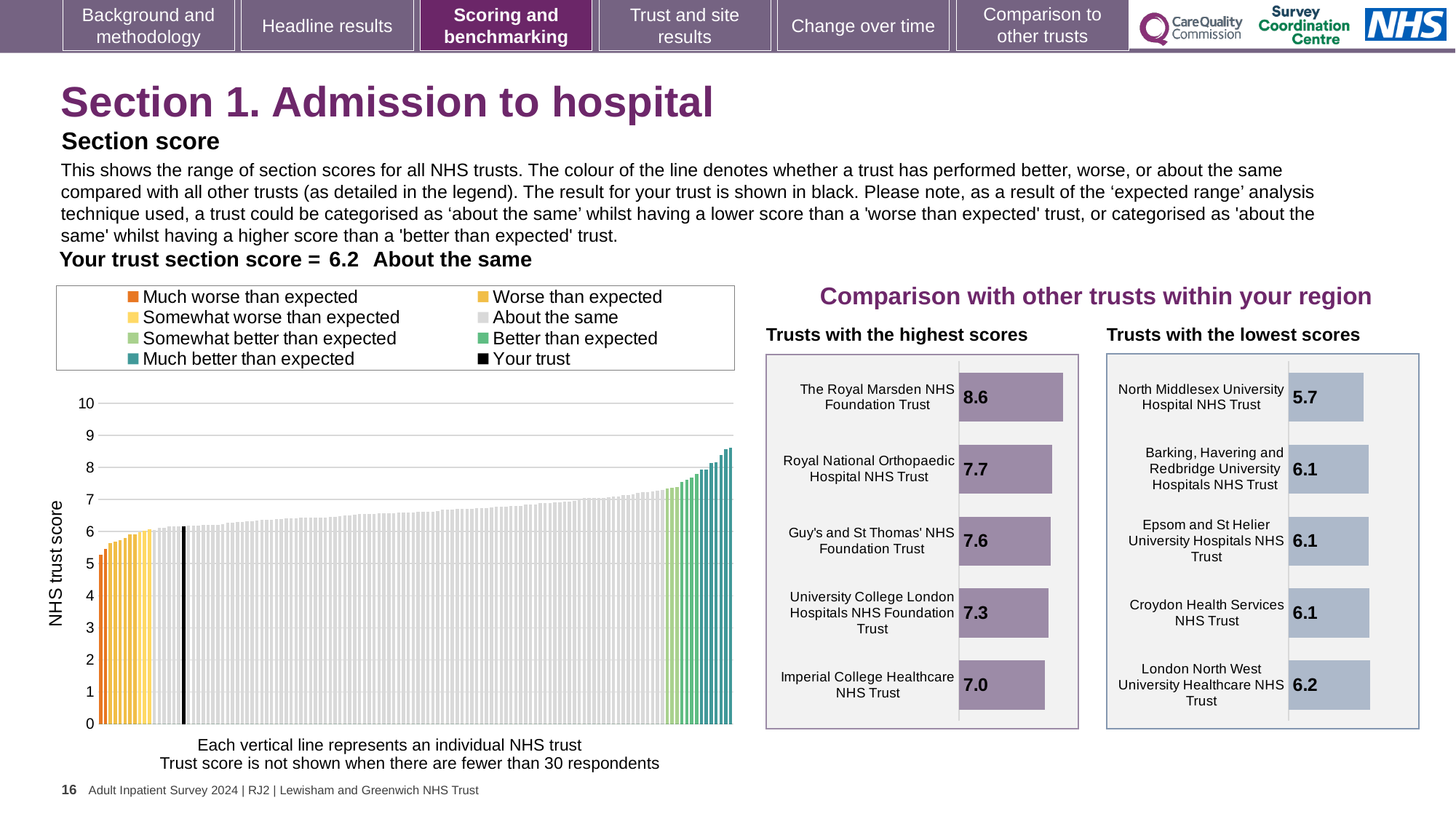
What kind of chart is the large 'NHS trust score' chart on the left? Bar chart How many entries does the legend of the 'NHS trust score' chart on the left list? 8 In the 'Trusts with the highest scores' chart, what is the difference between the scores of The Royal Marsden NHS Foundation Trust and Imperial College Healthcare NHS Trust? 1.6 In the 'Trusts with the lowest scores' chart, what is the difference between the scores of London North West University Healthcare NHS Trust and North Middlesex University Hospital NHS Trust? 0.5 In the 'Trusts with the lowest scores' chart, what is the score for North Middlesex University Hospital NHS Trust? 5.7 In the 'NHS trust score' chart on the left, what is the section score for your trust (shown in black)? 6.2 In the 'Trusts with the highest scores' chart, which trust has the highest score? The Royal Marsden NHS Foundation Trust In the 'Trusts with the lowest scores' chart, what is the score for Croydon Health Services NHS Trust? 6.1 In the 'Trusts with the highest scores' chart, which has the higher score: Guy's and St Thomas' NHS Foundation Trust or University College London Hospitals NHS Foundation Trust? Guy's and St Thomas' NHS Foundation Trust How many trusts are shown in the 'Trusts with the highest scores' chart? 5 In the 'Trusts with the highest scores' chart, what is the score for The Royal Marsden NHS Foundation Trust? 8.6 In the 'Trusts with the lowest scores' chart, which trust has the lowest score? North Middlesex University Hospital NHS Trust